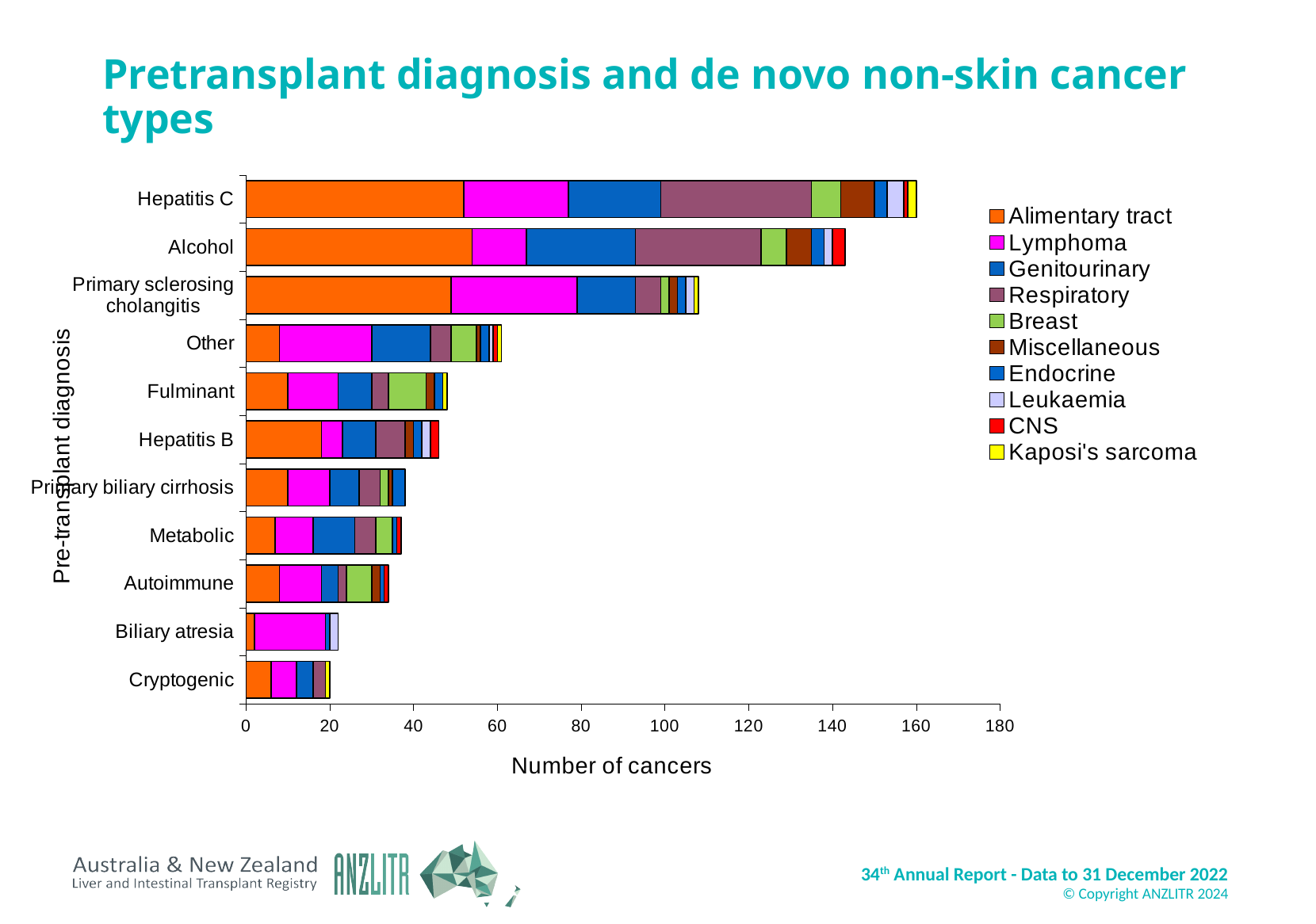
Is the total number of cancers for Cryptogenic greater or less than 40? less Is the total number of cancers for Alcohol greater or less than 160? less Is the total number of cancers for Other greater or less than 80? less Which cancer type is listed first in the legend? Alimentary tract How many pre-transplant diagnosis categories are plotted on the y axis? 11 Which pre-transplant diagnosis has the highest total number of cancers? Hepatitis C What is the title of the x axis? Number of cancers How many cancer types does the legend list? 10 What kind of chart is shown on the slide? Stacked bar chart Which has a larger total number of cancers, Alcohol or Primary sclerosing cholangitis? Alcohol